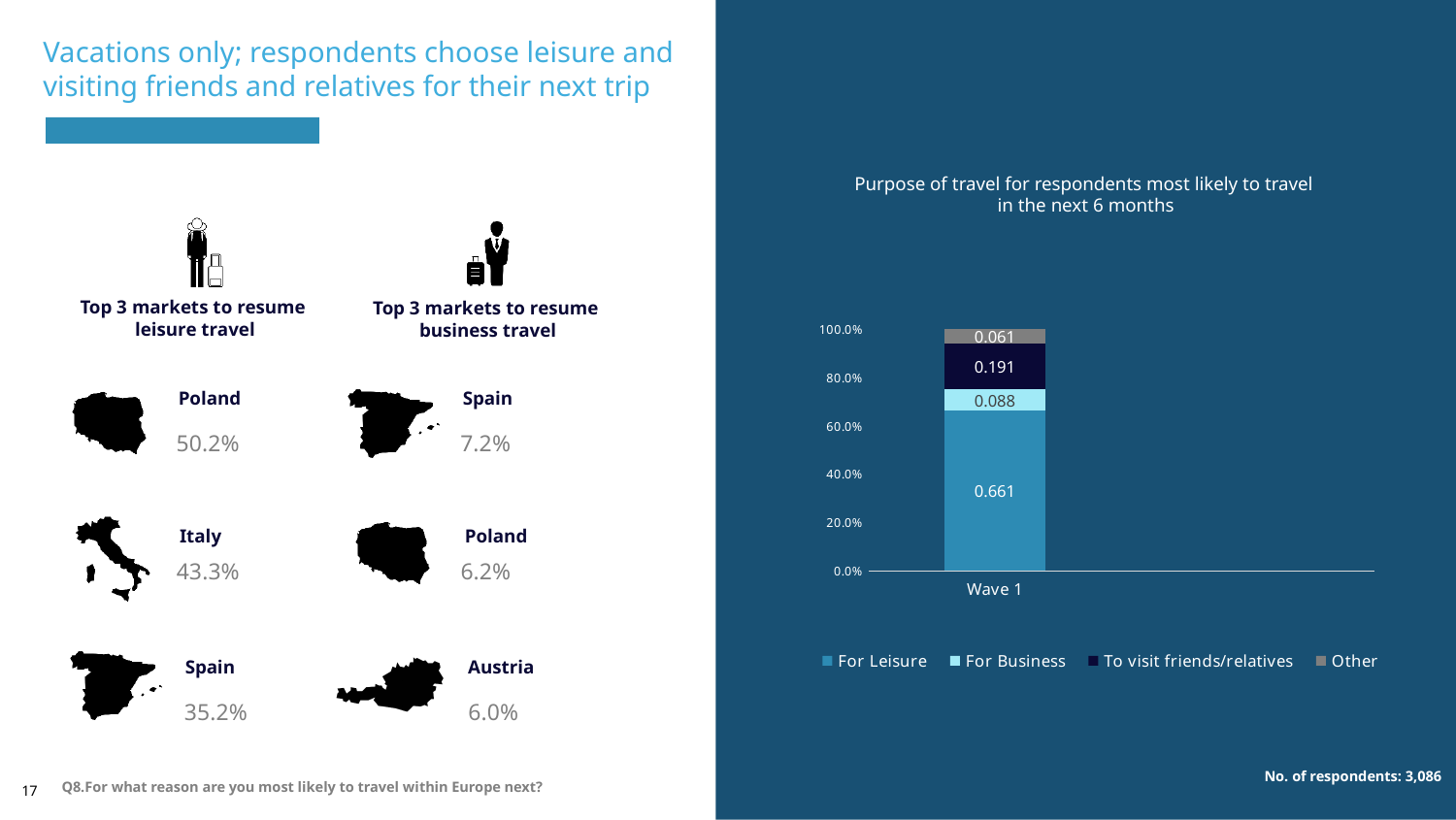
What kind of chart is shown on the slide? Stacked bar chart Which purpose of travel has the largest share in the Wave 1 bar? For Leisure What is the value for 'To visit friends/relatives' in the Wave 1 bar? 0.191 What is the value for 'For Leisure' in the Wave 1 bar? 0.661 What is the difference between the 'For Leisure' value and the 'To visit friends/relatives' value? 0.470 Which is larger, the 'For Business' value or the 'Other' value? For Business How many series does the legend list? 4 Which purpose of travel has the smallest share in the Wave 1 bar? Other What is the difference between the 'To visit friends/relatives' value and the 'For Business' value? 0.103 What is the value for 'Other' in the Wave 1 bar? 0.061 How many categories are shown on the x axis of the chart? 1 What is the value for 'For Business' in the Wave 1 bar? 0.088